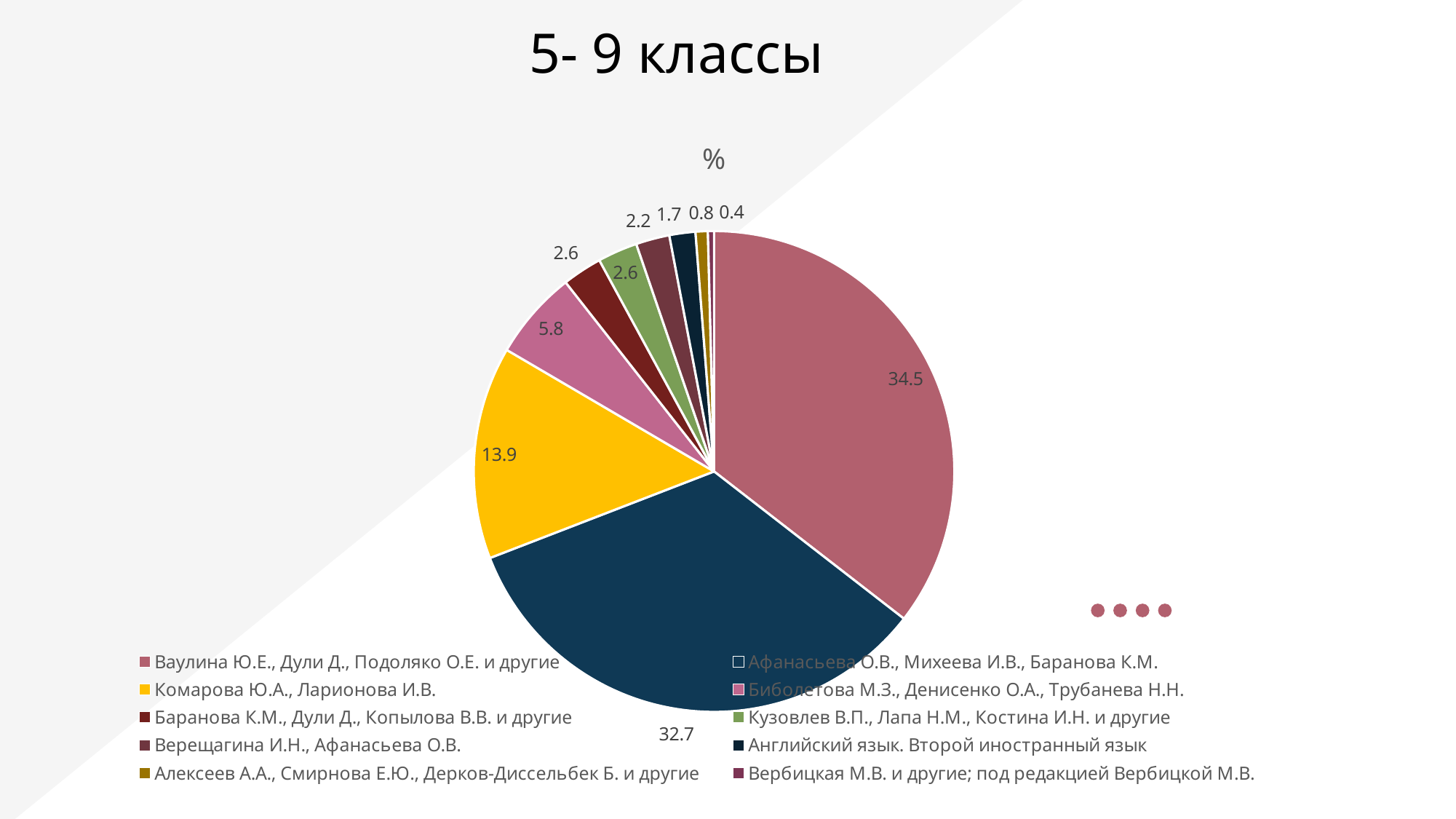
What is the value for Алексеев А.А., Смирнова Е.Ю., Дерков-Диссельбек Б. и другие? 0.8 What is the value for Комарова Ю.А., Ларионова И.В.? 13.9 What is the value for Ваулина Ю.Е., Дули Д., Подоляко О.Е. и другие? 34.5 Which category has the smallest slice of the pie? Вербицкая М.В. и другие; под редакцией Вербицкой М.В. What is the value for Верещагина И.Н., Афанасьева О.В.? 2.2 Which category has the largest slice of the pie? Ваулина Ю.Е., Дули Д., Подоляко О.Е. и другие What is the title of the chart? % What is the value for Биболетова М.З., Денисенко О.А., Трубанева Н.Н.? 5.8 Which is larger: the slice for Комарова Ю.А., Ларионова И.В. or the slice for Биболетова М.З., Денисенко О.А., Трубанева Н.Н.? Комарова Ю.А., Ларионова И.В. How many categories does the pie chart have? 10 What is the difference between the two largest slices, 34.5 and 32.7? 1.8 What kind of chart is shown on the slide? pie chart